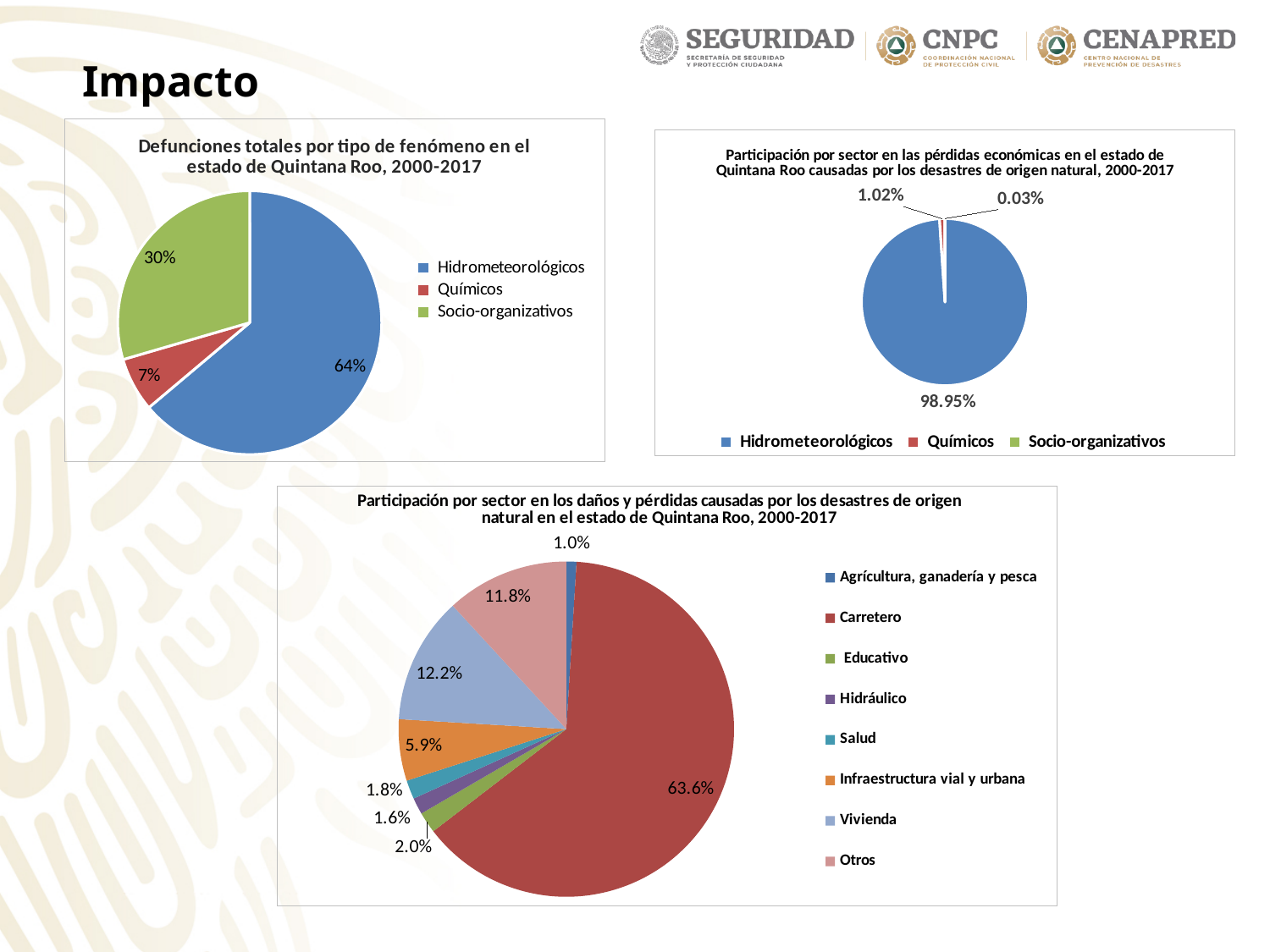
In the bottom chart on daños y pérdidas by sector, what share is Vivienda? 12.2% In the bottom chart on daños y pérdidas by sector, what share is Carretero? 63.6% In the bottom chart on daños y pérdidas by sector, which is larger, Vivienda or Otros? Vivienda In the chart titled 'Defunciones totales por tipo de fenómeno en el estado de Quintana Roo, 2000-2017', what share is Socio-organizativos? 30% In the chart titled 'Defunciones totales por tipo de fenómeno en el estado de Quintana Roo, 2000-2017', what is the difference between the Hidrometeorológicos and Socio-organizativos shares? 34% In the chart titled 'Defunciones totales por tipo de fenómeno en el estado de Quintana Roo, 2000-2017', which category has the smallest slice? Químicos In the top-right chart on economic losses (pérdidas económicas), what share is Químicos? 1.02% What type of chart is the bottom chart on daños y pérdidas by sector? Pie chart In the top-right chart on economic losses (pérdidas económicas), which category has the smallest share? Socio-organizativos In the bottom chart on daños y pérdidas by sector, how many sectors does the legend list? 8 In the top-right chart on economic losses (pérdidas económicas), what share is Hidrometeorológicos? 98.95% In the chart titled 'Defunciones totales por tipo de fenómeno en el estado de Quintana Roo, 2000-2017', what share is Hidrometeorológicos? 64%